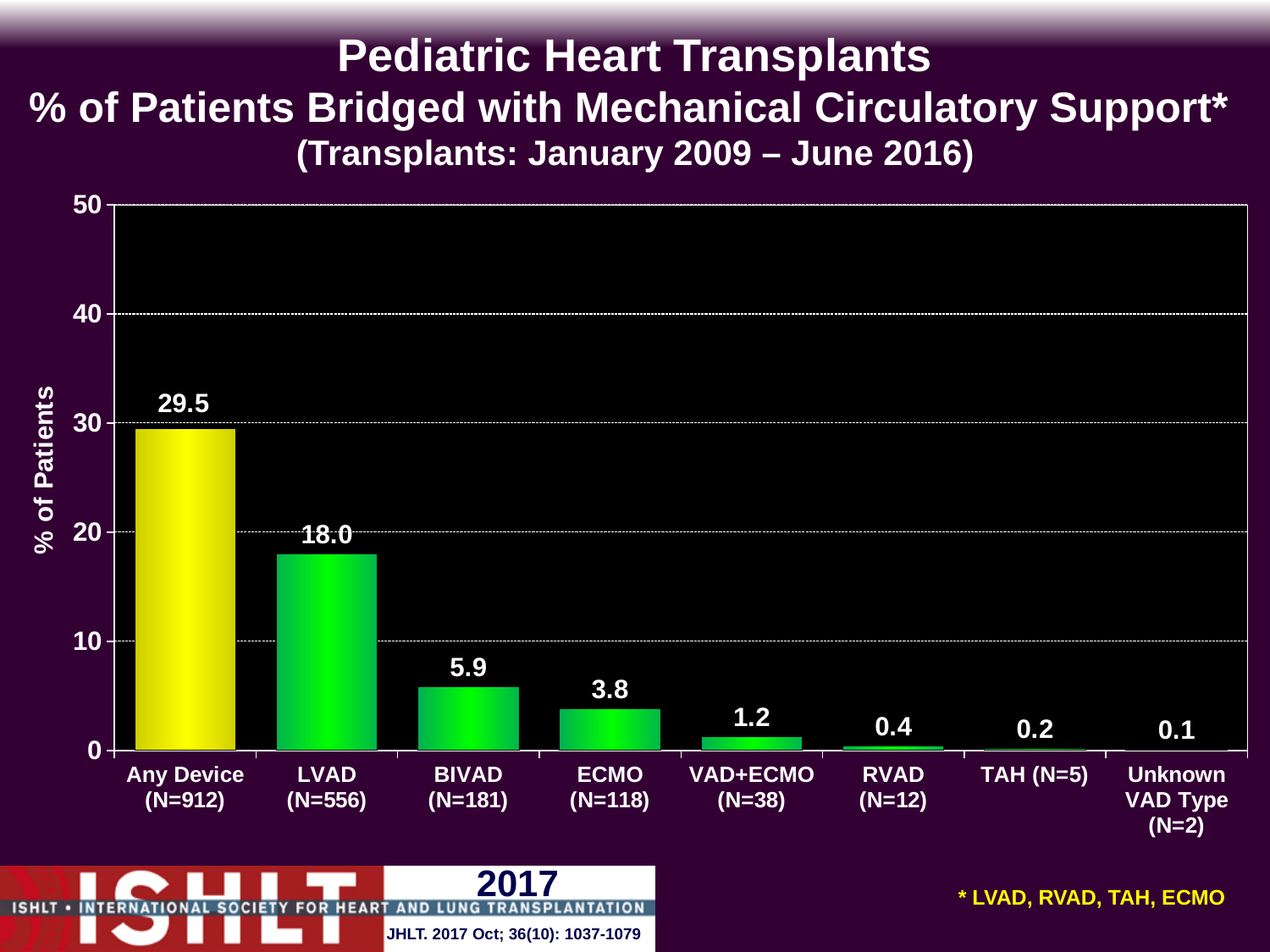
What is the difference between the values for Any Device (N=912) and LVAD (N=556)? 11.5 What is the label of the y axis? % of Patients Which category has the lowest value? Unknown VAD Type (N=2) What is the value for LVAD (N=556)? 18.0 What is the value for ECMO (N=118)? 3.8 How many categories are shown on the x axis? 8 What is the value for VAD+ECMO (N=38)? 1.2 What is the difference between the values for BIVAD (N=181) and ECMO (N=118)? 2.1 Which is larger, the value for BIVAD (N=181) or the value for RVAD (N=12)? BIVAD (N=181) Which category has the highest value? Any Device (N=912) What kind of chart is shown on the slide? bar chart Is the value for Any Device (N=912) greater or less than 20? greater